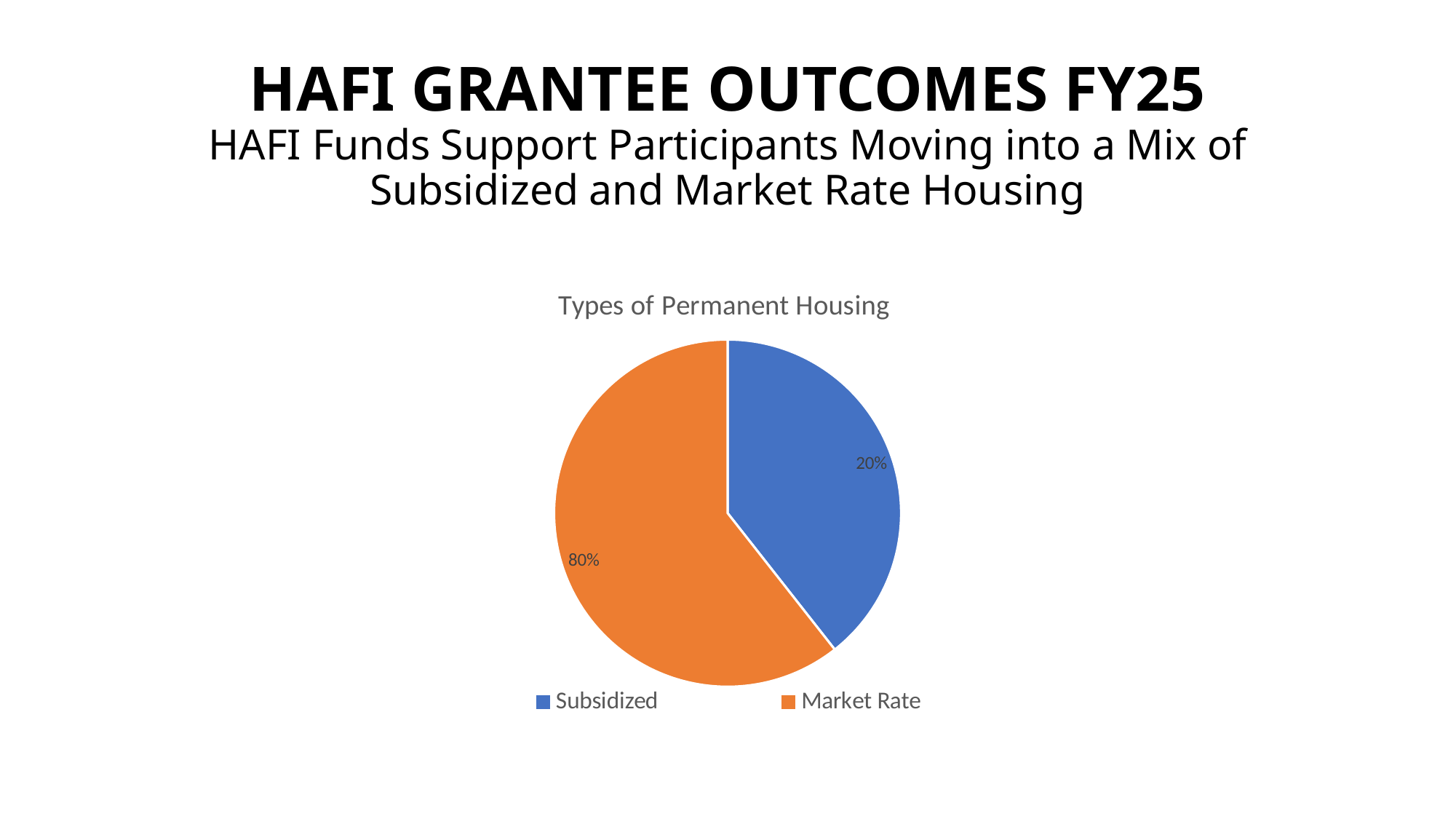
Which is larger, the Subsidized slice or the Market Rate slice? Market Rate What is the total of the two slices shown in the pie chart? 100% What share of the pie does Market Rate housing represent? 80% What kind of chart is shown on the slide? Pie chart What is the title of the chart? Types of Permanent Housing Which category has the smallest slice of the pie? Subsidized How many categories are shown in the pie chart? 2 Which category has the largest slice of the pie? Market Rate What is the difference in percentage points between the Market Rate and Subsidized slices? 60 What share of the pie does Subsidized housing represent? 20% What colour is the Market Rate slice? Orange